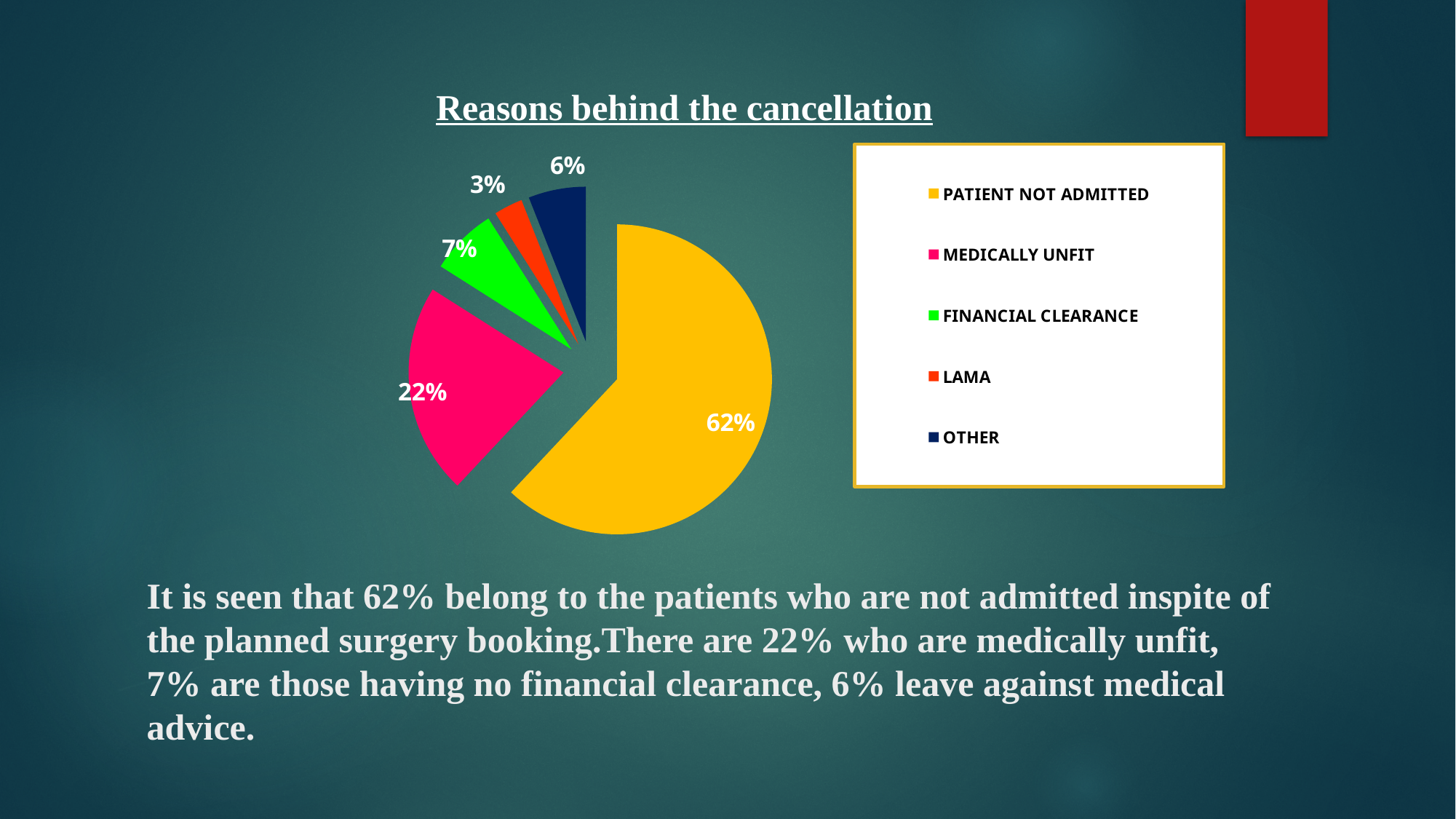
Which reason accounts for the largest share of cancellations? PATIENT NOT ADMITTED What percentage of cancellations is attributed to PATIENT NOT ADMITTED? 62% What is the title of the chart? Reasons behind the cancellation What is the difference in percentage points between PATIENT NOT ADMITTED and MEDICALLY UNFIT? 40 What percentage of cancellations is attributed to MEDICALLY UNFIT? 22% What percentage of cancellations is attributed to FINANCIAL CLEARANCE? 7% How many reasons (slices) are shown in the pie chart? 5 Which reason accounts for the smallest share of cancellations? LAMA What type of chart is shown on the slide? pie chart Which is larger, the share for FINANCIAL CLEARANCE or the share for OTHER? FINANCIAL CLEARANCE What colour is the slice for MEDICALLY UNFIT? pink What percentage of cancellations is attributed to OTHER? 6%